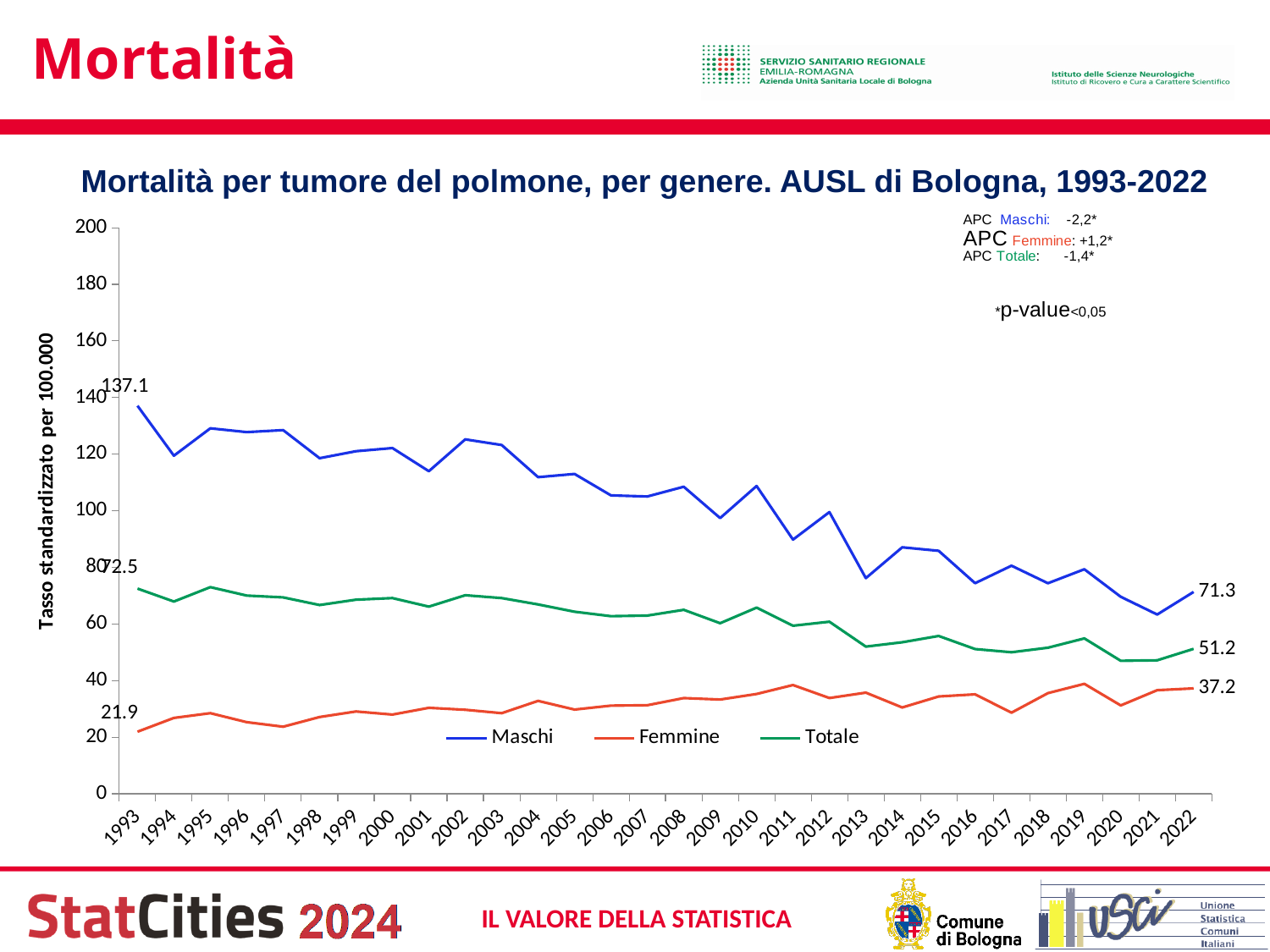
Is the value for Maschi in 2010 greater or less than 100? greater Does the Maschi line rise or fall overall from 1993 to 2022? fall What is the value for Femmine in 2022? 37.2 How many series does the legend list? 3 What is the value for Maschi in 2022? 71.3 What is the value for Totale in 1993? 72.5 What kind of chart is shown on the slide? line chart What is the value for Maschi in 1993? 137.1 By how much did the Maschi value decrease from 1993 to 2022? 65.8 By how much did the Femmine value increase from 1993 to 2022? 15.3 Does the Femmine line rise or fall overall from 1993 to 2022? rise What is the value for Totale in 2022? 51.2